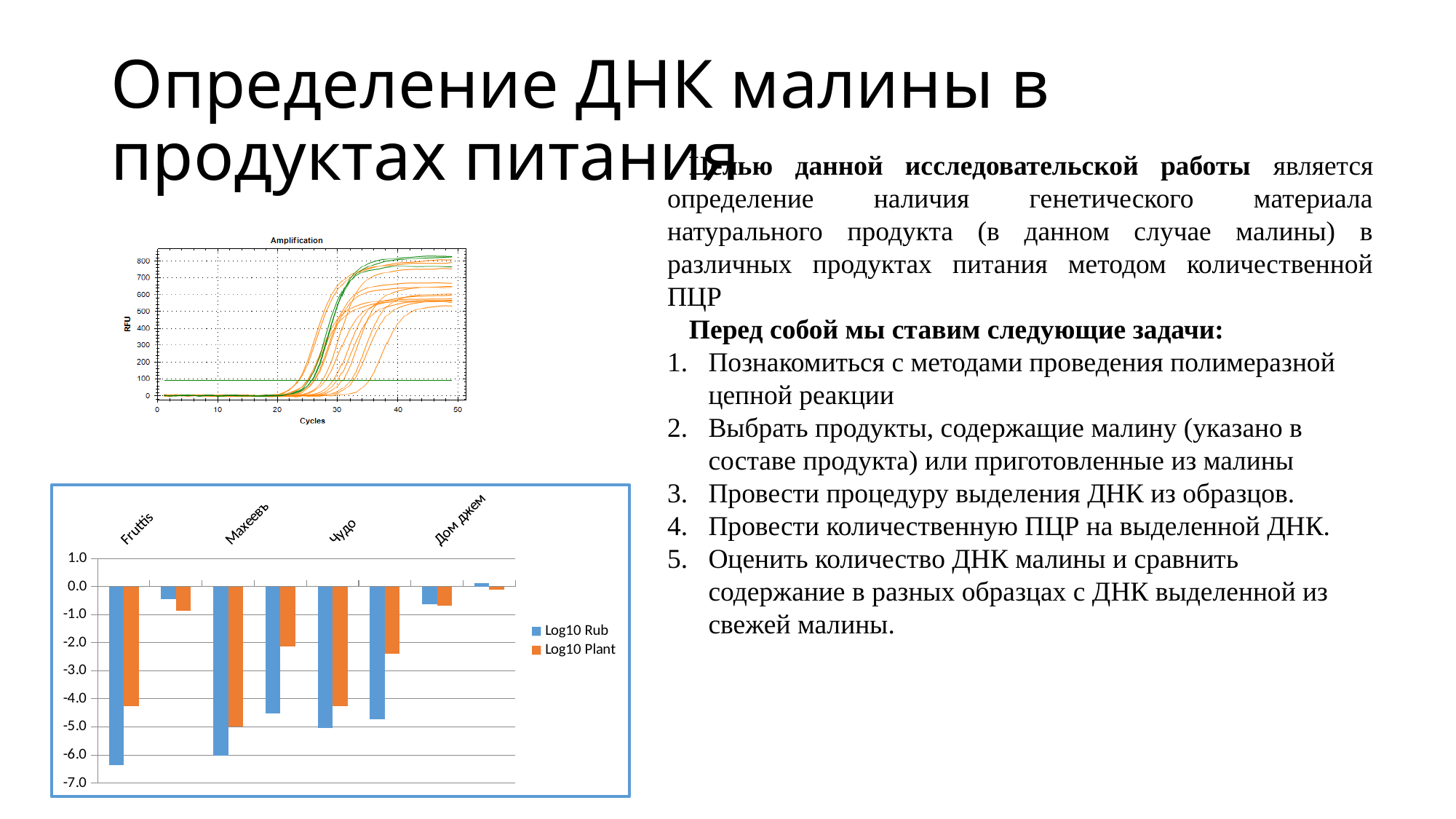
In the 'Amplification' chart, do the curves rise or fall as the number of cycles increases? rise How many groups of bars are plotted in the bottom-left bar chart? 8 What type of chart is the chart at the bottom left of the slide? bar chart How many series does the legend of the bottom-left bar chart list? 2 What type of chart is the 'Amplification' chart? line chart What is the highest tick value shown on the y axis of the 'Amplification' chart? 800 In the bottom-left bar chart, for the leftmost group, which series has the larger (less negative) value, Log10 Rub or Log10 Plant? Log10 Plant What are the two legend entries of the bottom-left bar chart? Log10 Rub, Log10 Plant In the bottom-left bar chart, is the Log10 Rub value for the leftmost group greater or less than -5.0? less What is the label of the x axis of the 'Amplification' chart? Cycles In the bottom-left bar chart, what colour are the Log10 Plant bars? orange In the bottom-left bar chart, is the Log10 Plant value for the leftmost group greater or less than -3.0? less